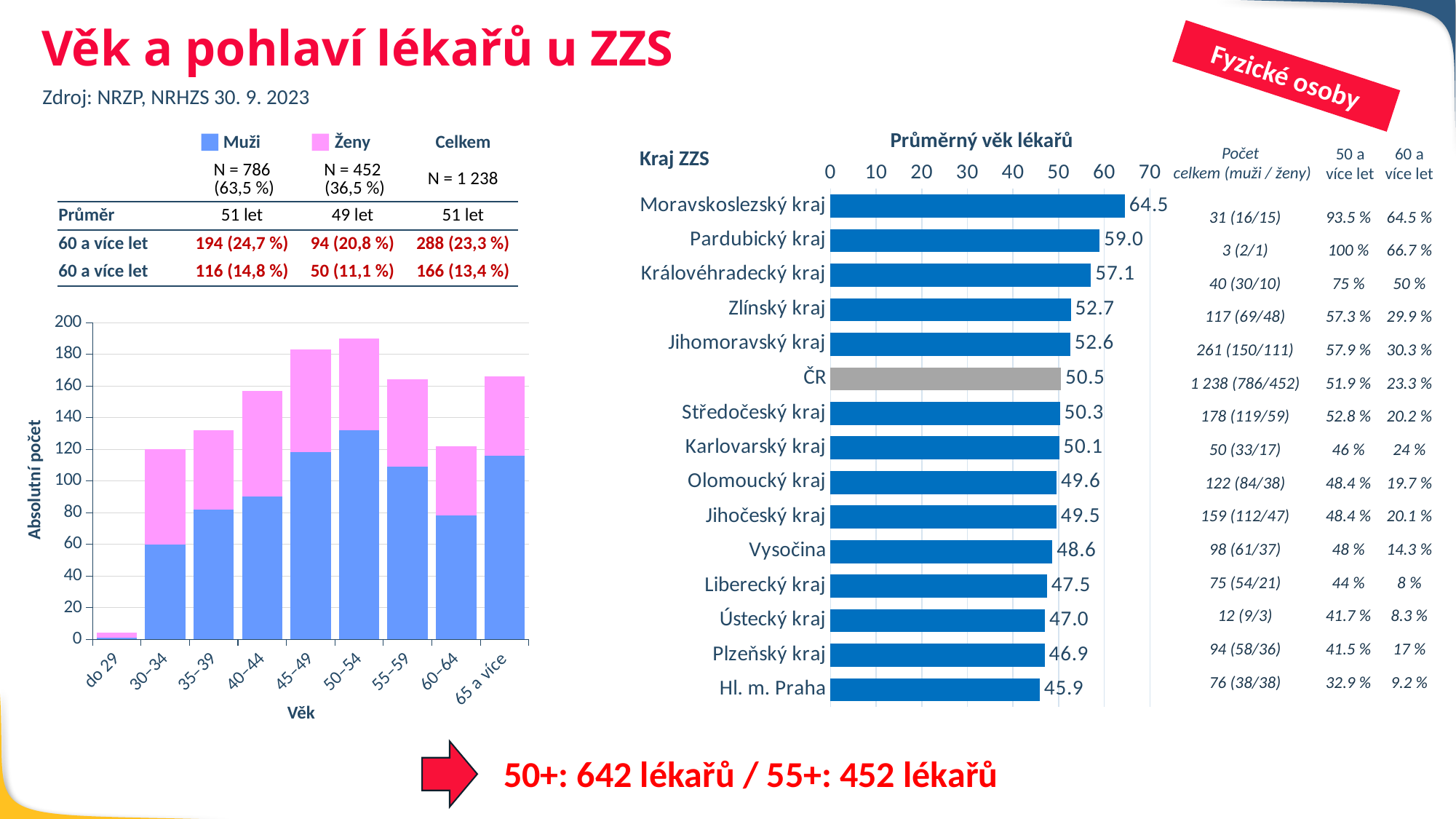
In the chart titled 'Průměrný věk lékařů', which region has the highest average age? Moravskoslezský kraj In the chart titled 'Průměrný věk lékařů', what is the value for ČR? 50.5 In the chart titled 'Průměrný věk lékařů', what is the value for Moravskoslezský kraj? 64.5 In the stacked bar chart on the left, which age group has the lowest total count? do 29 What kind of chart is the chart titled 'Průměrný věk lékařů'? Bar chart In the chart titled 'Průměrný věk lékařů', which is larger, the value for Pardubický kraj or Královéhradecký kraj? Pardubický kraj In the chart titled 'Průměrný věk lékařů', how many bars are plotted? 15 In the chart titled 'Průměrný věk lékařů', what is the difference between the values for Moravskoslezský kraj and Hl. m. Praha? 18.6 In the stacked bar chart on the left, is the total for the 45–49 age group greater or less than 160? greater In the stacked bar chart on the left, how many series does the legend list? 2 In the chart titled 'Průměrný věk lékařů', which region has the lowest average age? Hl. m. Praha In the stacked bar chart on the left, how many age groups are shown on the x axis? 9